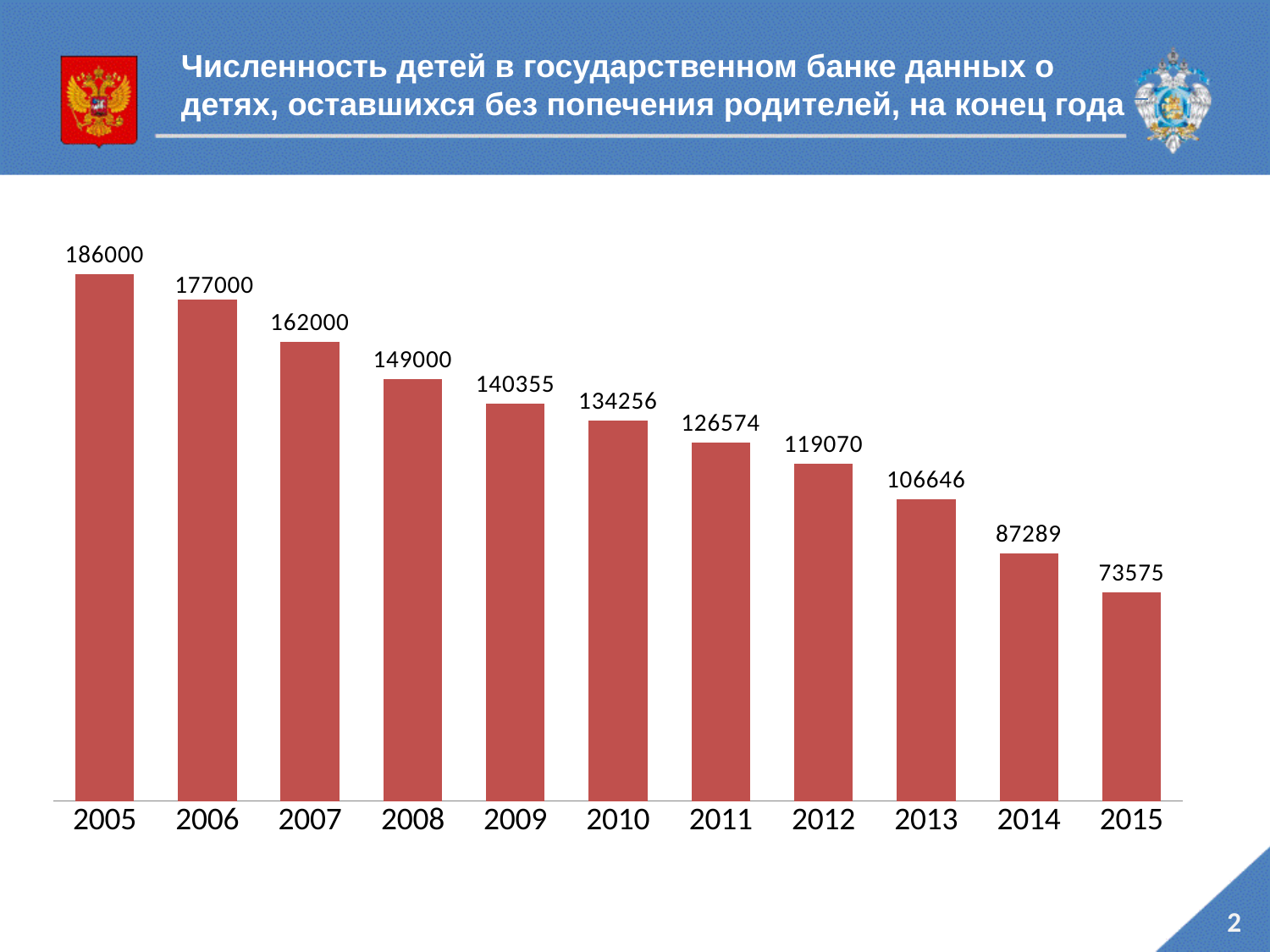
How many years are shown on the x axis? 11 Which year has the lowest value? 2015 What is the value for 2013? 106646 What is the value for 2009? 140355 What is the difference between the values for 2013 and 2014? 19357 Which is larger, the value for 2010 or the value for 2012? 2010 Do the values rise or fall from 2005 to 2015? fall What is the difference between the values for 2005 and 2015? 112425 What is the value for 2005? 186000 What is the value for 2015? 73575 Which year has the highest value? 2005 What kind of chart is shown on the slide? bar chart